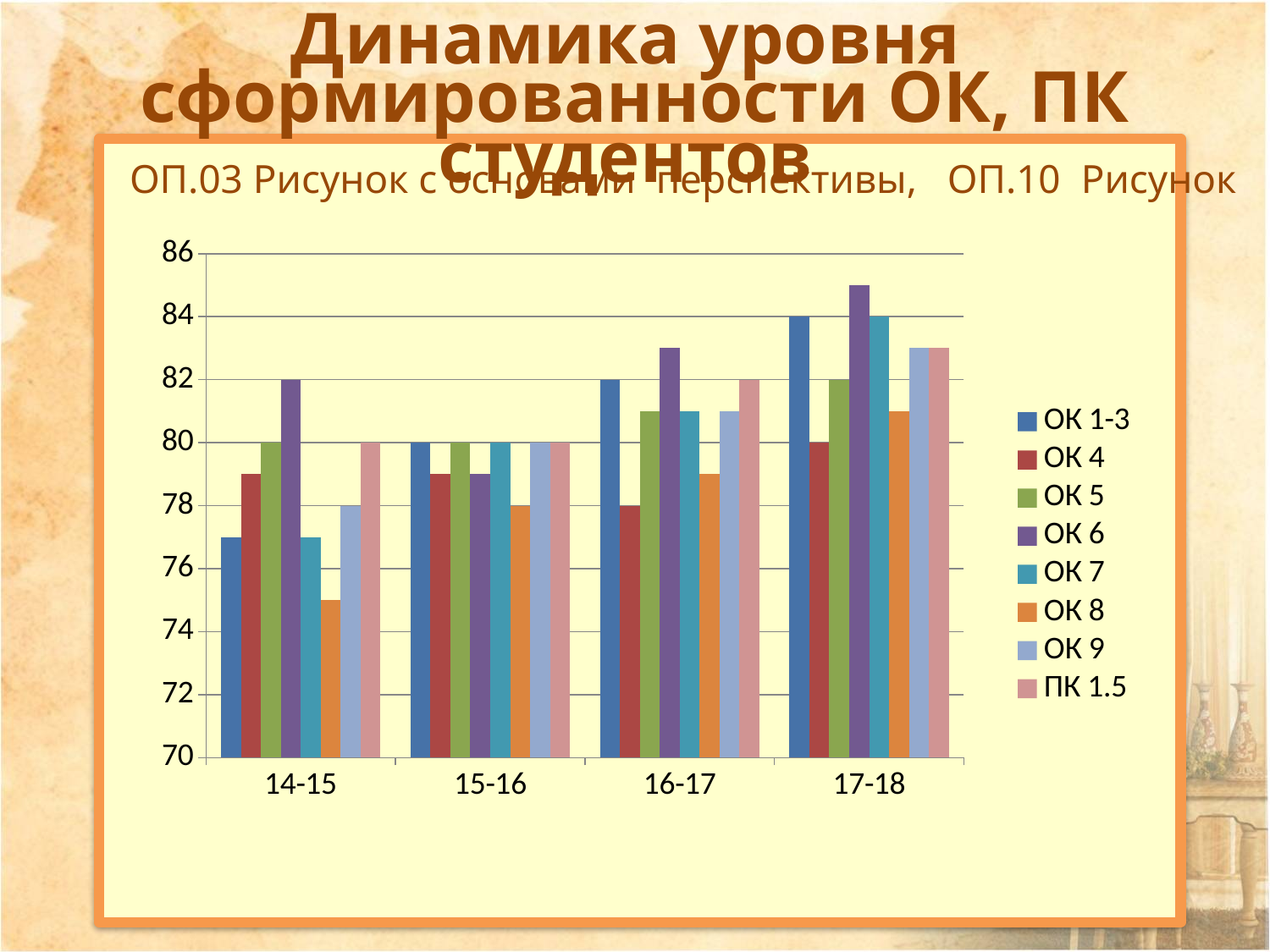
How many series does the legend list? 8 What kind of chart is shown on the slide? bar chart What is the value for ОК 6 in 14-15? 82 Which series has the lowest value in 14-15? ОК 8 Which series has the highest value in 17-18? ОК 6 Do the values for ОК 1-3 rise or fall from 14-15 to 17-18? rise What is the difference between the ОК 1-3 values in 17-18 and 15-16? 4 What is the value for ОК 9 in 14-15? 78 Is the value for ОК 8 in 14-15 greater or less than 76? less How many categories are shown on the x axis? 4 What is the value for ОК 1-3 in 17-18? 84 What is the value for ОК 1-3 in 15-16? 80